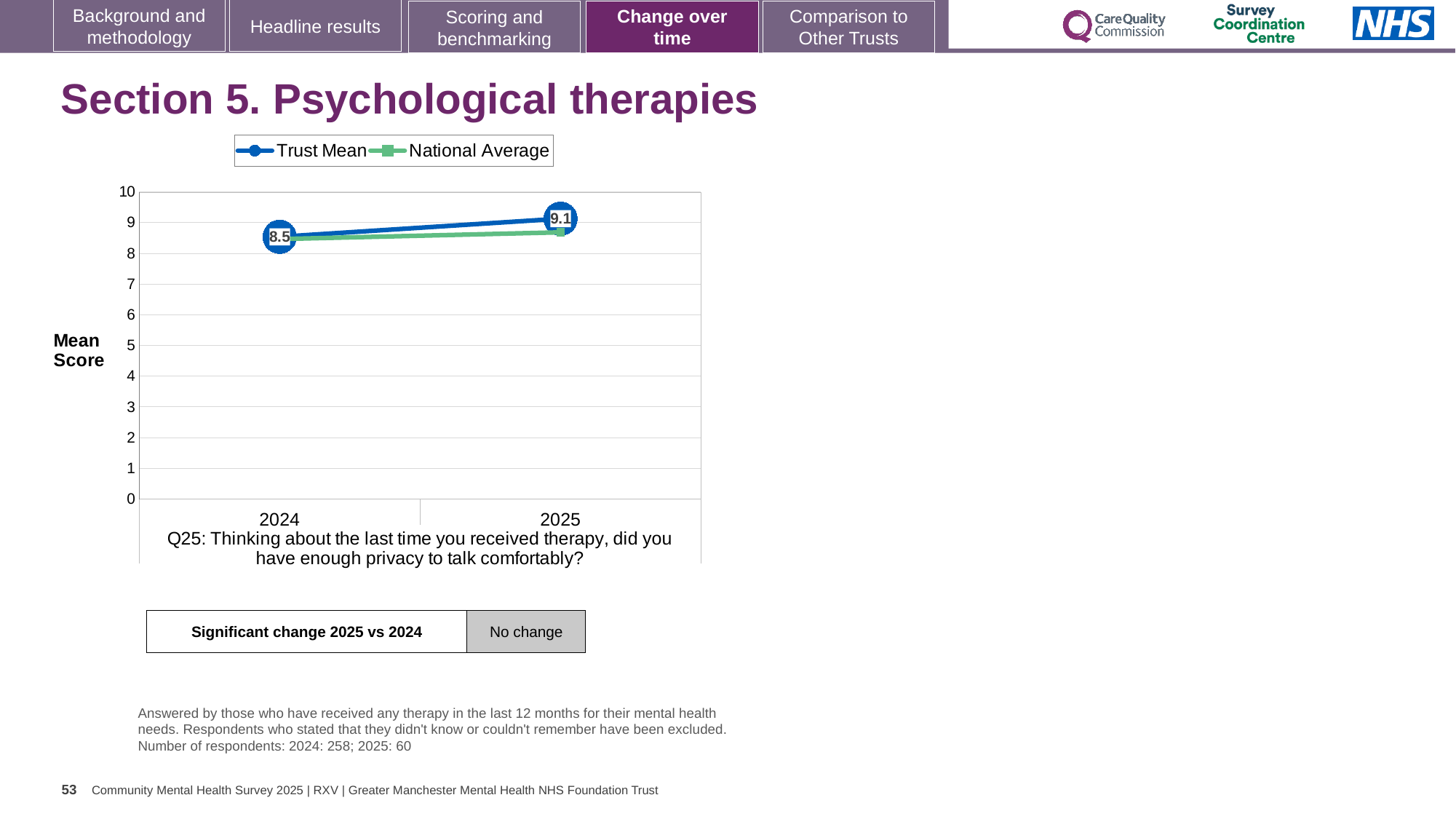
How many series does the legend list? 2 In 2025, which series is higher, Trust Mean or National Average? Trust Mean What is the Trust Mean score for 2024? 8.5 What kind of chart is shown on the slide? line chart How many years are plotted on the x axis? 2 What is the label on the y axis of the chart? Mean Score By how much did the Trust Mean change from 2024 to 2025? 0.6 Which year has the higher Trust Mean score, 2024 or 2025? 2025 Does the Trust Mean rise or fall from 2024 to 2025? rise What is the Trust Mean score for 2025? 9.1 Is the National Average value for 2024 greater or less than 5? greater Is the National Average value for 2025 greater or less than 8? greater